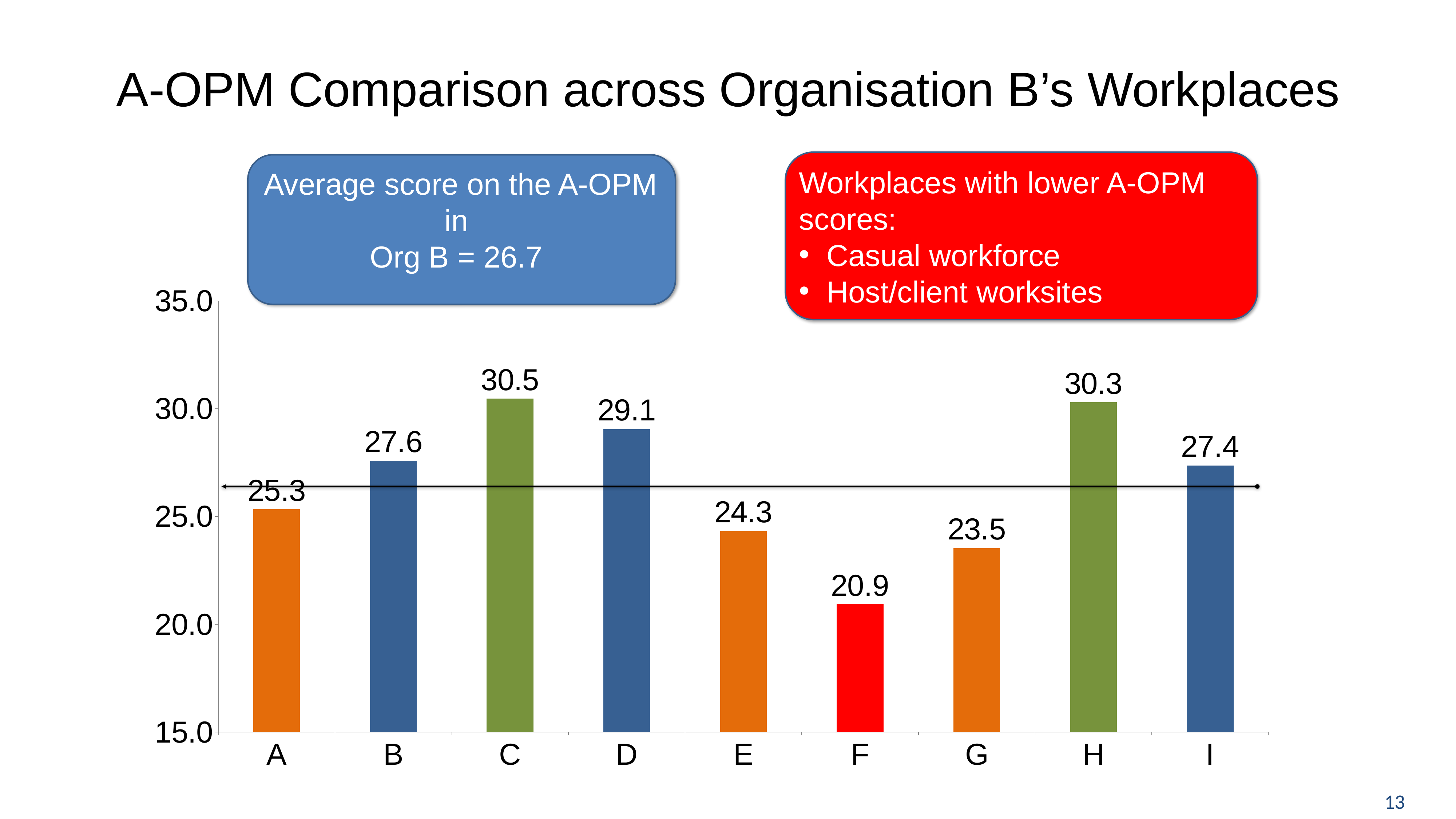
How many workplaces are shown on the chart? 9 Which workplace has the lowest A-OPM score? F What is the difference between the A-OPM scores of workplaces C and F? 9.6 What is the A-OPM score for workplace C? 30.5 Is the value for workplace H greater or less than 30? greater What is the A-OPM score for workplace F? 20.9 What is the A-OPM score for workplace I? 27.4 What is the average A-OPM score for Org B stated on the slide? 26.7 Which workplace has the highest A-OPM score? C Which workplace has a higher A-OPM score, B or G? B What kind of chart is shown on the slide? Bar chart What is the difference between the A-OPM scores of workplaces D and E? 4.8